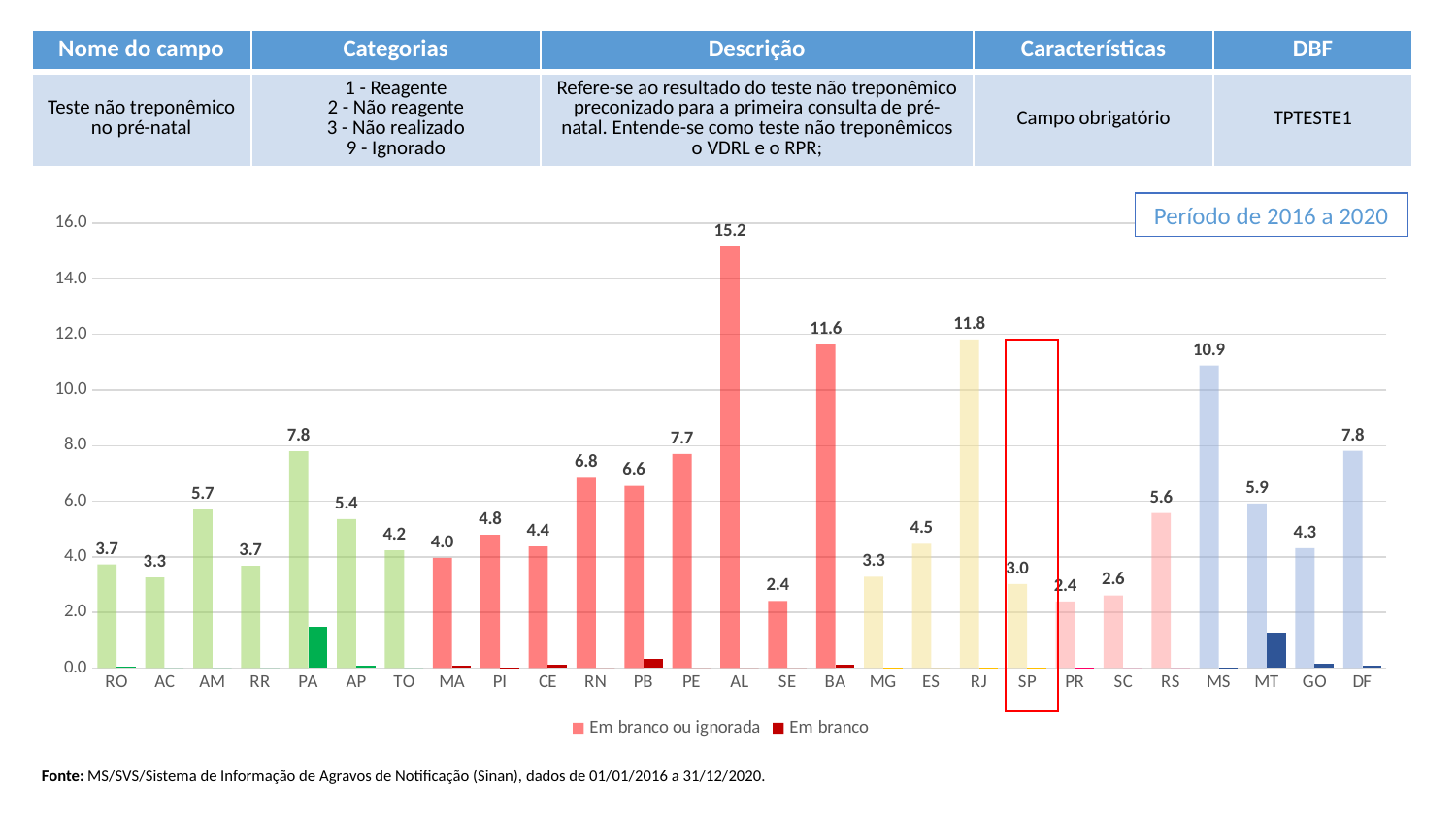
Is the 'Em branco ou ignorada' value for PA greater or less than 6.0? greater Which state is highlighted with a red box on the chart? SP What is the value for RS in the 'Em branco ou ignorada' series? 5.6 What kind of chart is shown on the slide? Bar chart How many states are shown on the x axis? 27 Which has a larger 'Em branco ou ignorada' value, MS or DF? MS What period does the chart cover, according to the box in the top right? Período de 2016 a 2020 What is the value for AL in the 'Em branco ou ignorada' series? 15.2 What is the value for SP in the 'Em branco ou ignorada' series? 3.0 Which state has the highest value in the 'Em branco ou ignorada' series? AL How many series does the legend list? 2 What is the difference between the 'Em branco ou ignorada' values for BA and RJ? 0.2